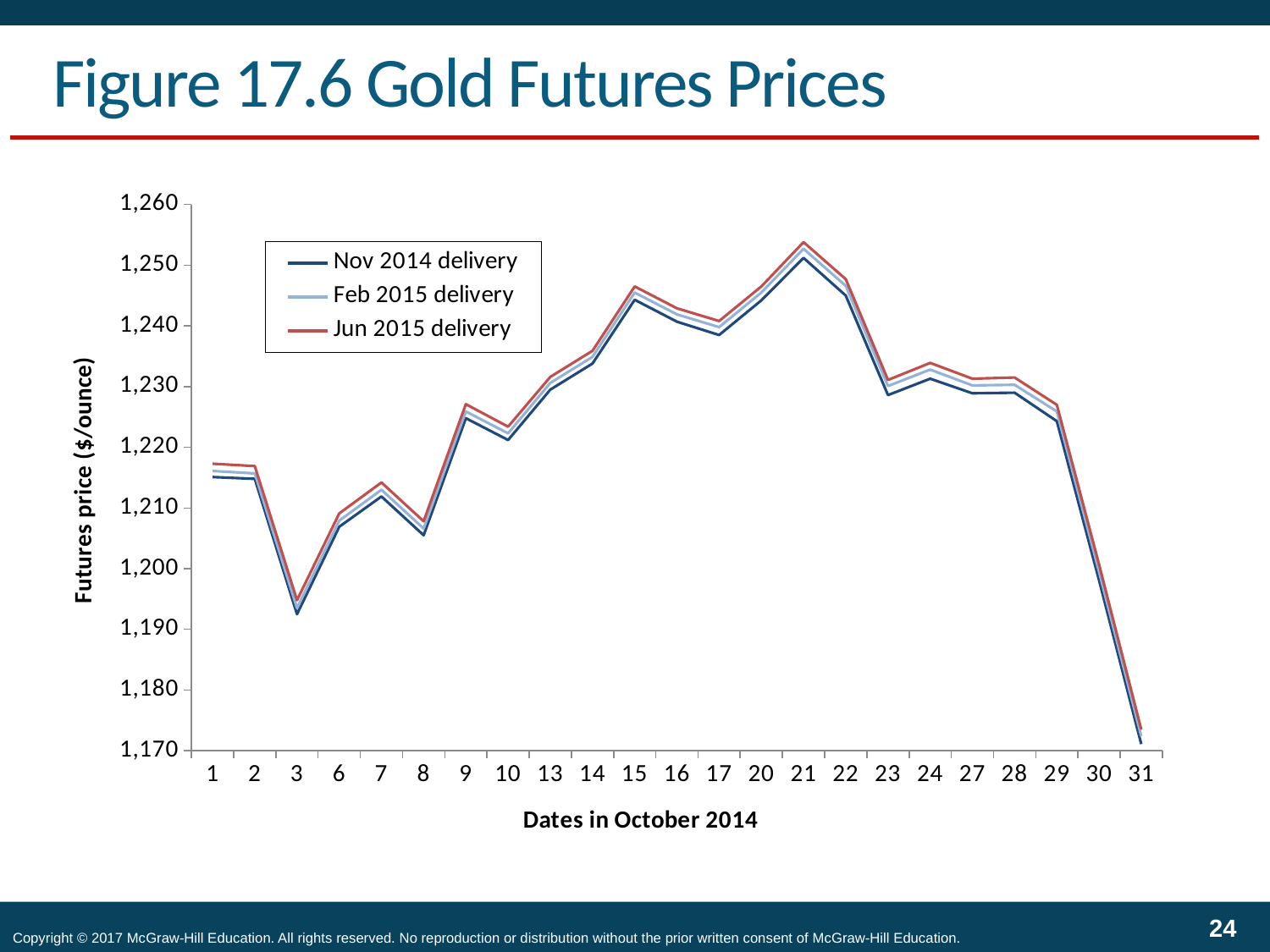
What kind of chart is shown on the slide? Line chart Is the Nov 2014 delivery price on October 31 greater or less than 1,180? less Which is higher for Nov 2014 delivery: the price on October 15 or the price on October 21? October 21 How many series does the legend list? 3 Is the Jun 2015 delivery price on October 21 greater or less than 1,240? greater Which series has the highest price on October 21? Jun 2015 delivery On which date in October 2014 do the gold futures prices reach their lowest point? 31 Do the futures prices rise or fall from October 29 to October 31? Fall Is the Nov 2014 delivery price on October 8 greater or less than 1,210? less On which date in October 2014 do the gold futures prices reach their highest point? 21 How many dates are labelled along the x axis? 23